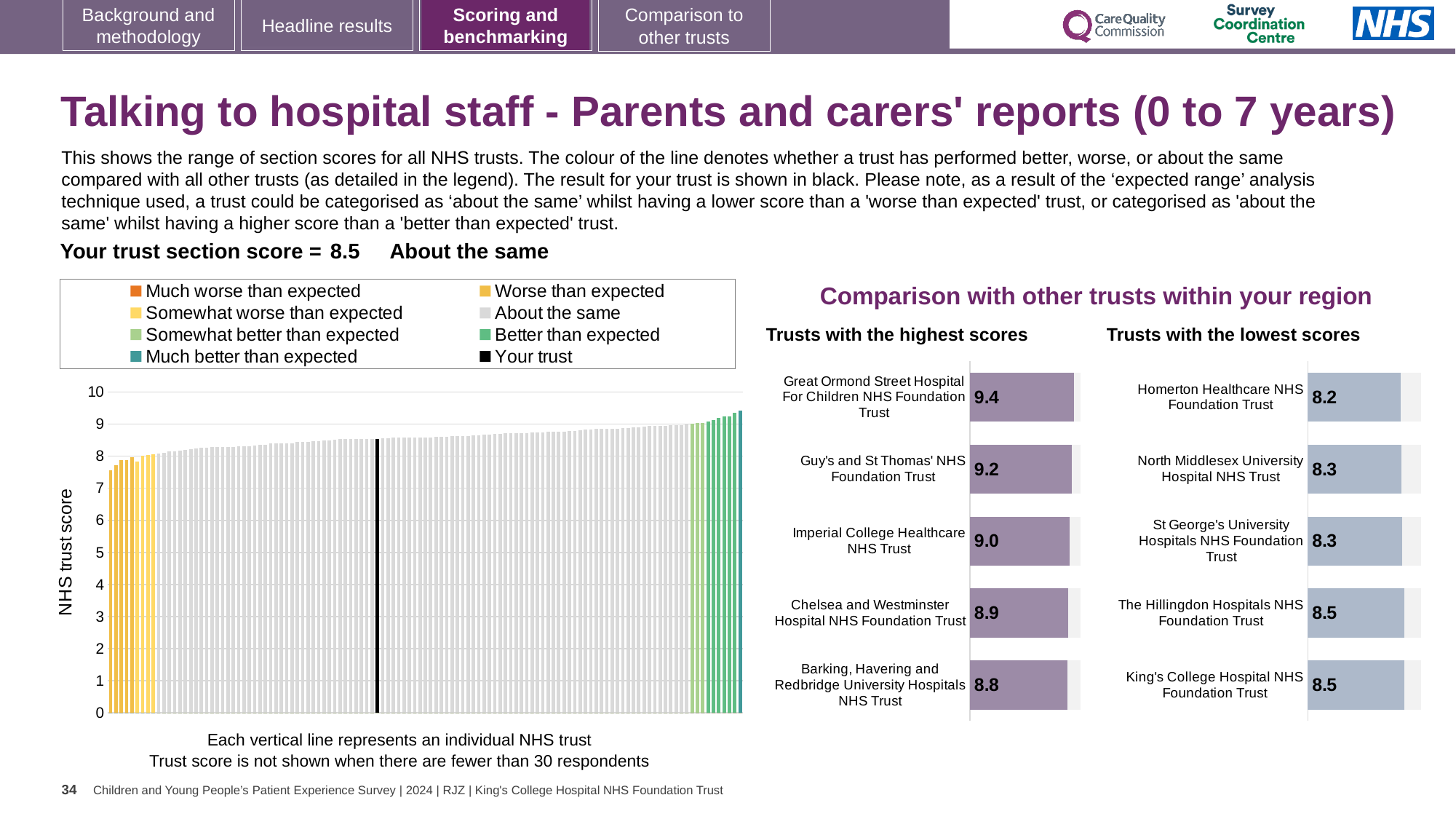
How many entries does the legend of the large 'NHS trust score' chart on the left list? 8 In the 'Trusts with the lowest scores' chart, which is larger: the score for North Middlesex University Hospital NHS Trust or The Hillingdon Hospitals NHS Foundation Trust? The Hillingdon Hospitals NHS Foundation Trust In the large 'NHS trust score' chart on the left, do the values rise or fall from left to right? Rise In the 'Trusts with the lowest scores' chart, what is the score for King's College Hospital NHS Foundation Trust? 8.5 In the 'Trusts with the lowest scores' chart, what is the score for Homerton Healthcare NHS Foundation Trust? 8.2 What kind of chart is the large chart on the left with the 'NHS trust score' axis? Bar chart In the large 'NHS trust score' chart on the left, is the value of the leftmost bar greater or less than 8? less In the 'Trusts with the lowest scores' chart, which trust has the lowest score? Homerton Healthcare NHS Foundation Trust How many trusts are shown in the 'Trusts with the highest scores' chart? 5 In the 'Trusts with the highest scores' chart, which trust has the lowest score? Barking, Havering and Redbridge University Hospitals NHS Trust In the 'Trusts with the highest scores' chart, what is the score for Great Ormond Street Hospital For Children NHS Foundation Trust? 9.4 In the 'Trusts with the highest scores' chart, what is the difference between the scores of Great Ormond Street Hospital For Children NHS Foundation Trust and Imperial College Healthcare NHS Trust? 0.4